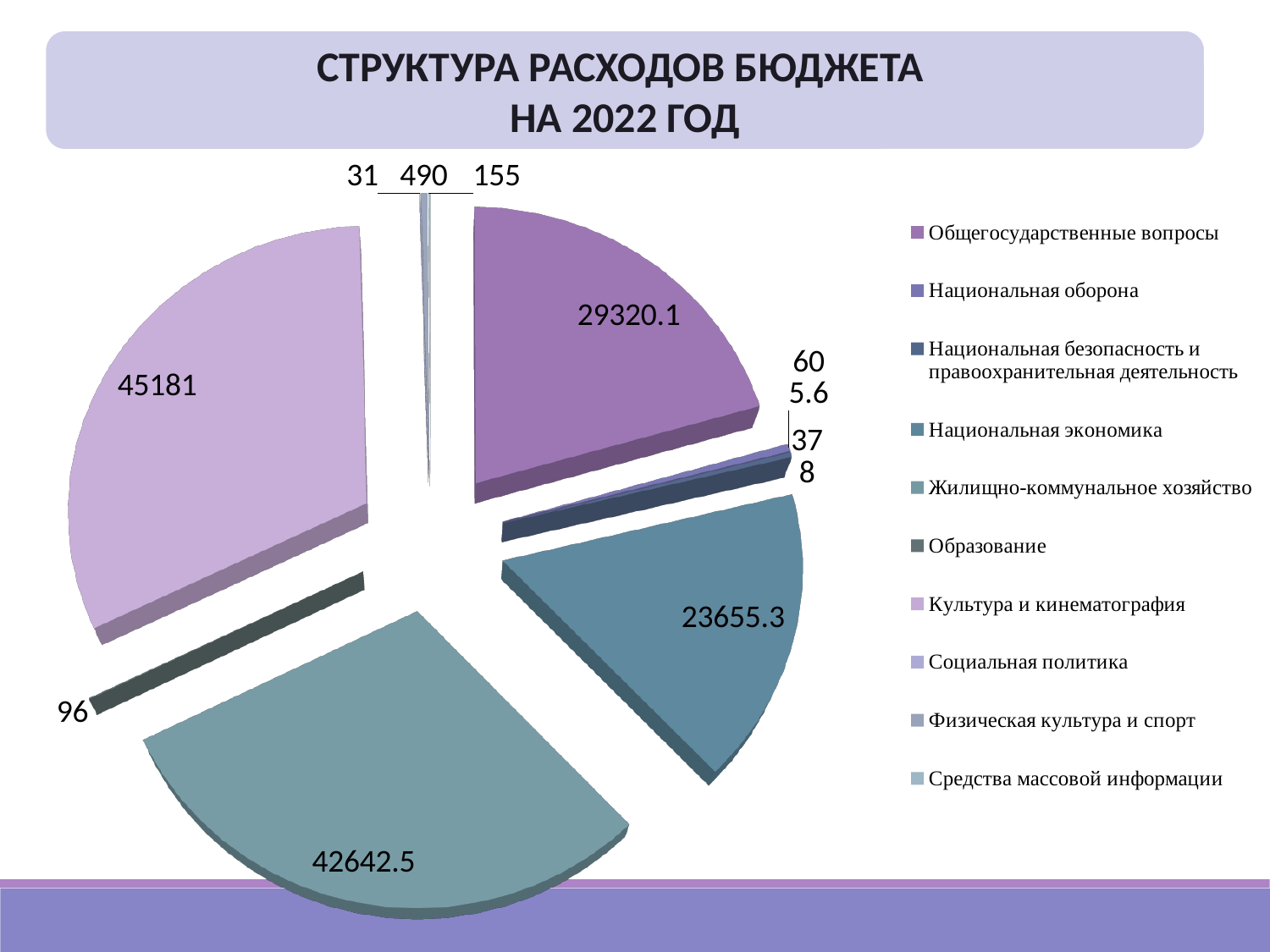
How many categories does the legend of the pie chart list? 10 Which is larger: Жилищно-коммунальное хозяйство or Национальная экономика? Жилищно-коммунальное хозяйство What is the title of the chart on the slide? СТРУКТУРА РАСХОДОВ БЮДЖЕТА НА 2022 ГОД What is the value shown for Жилищно-коммунальное хозяйство? 42642.5 Which category has the largest slice of the pie? Культура и кинематография What is the value shown for Образование? 96 What is the value shown for Национальная экономика? 23655.3 What type of chart is shown on the slide? Pie chart What is the value shown for Общегосударственные вопросы? 29320.1 What is the value shown for Культура и кинематография? 45181 What is the difference between the values for Общегосударственные вопросы and Национальная экономика? 5664.8 What is the difference between the values for Культура и кинематография and Жилищно-коммунальное хозяйство? 2538.5